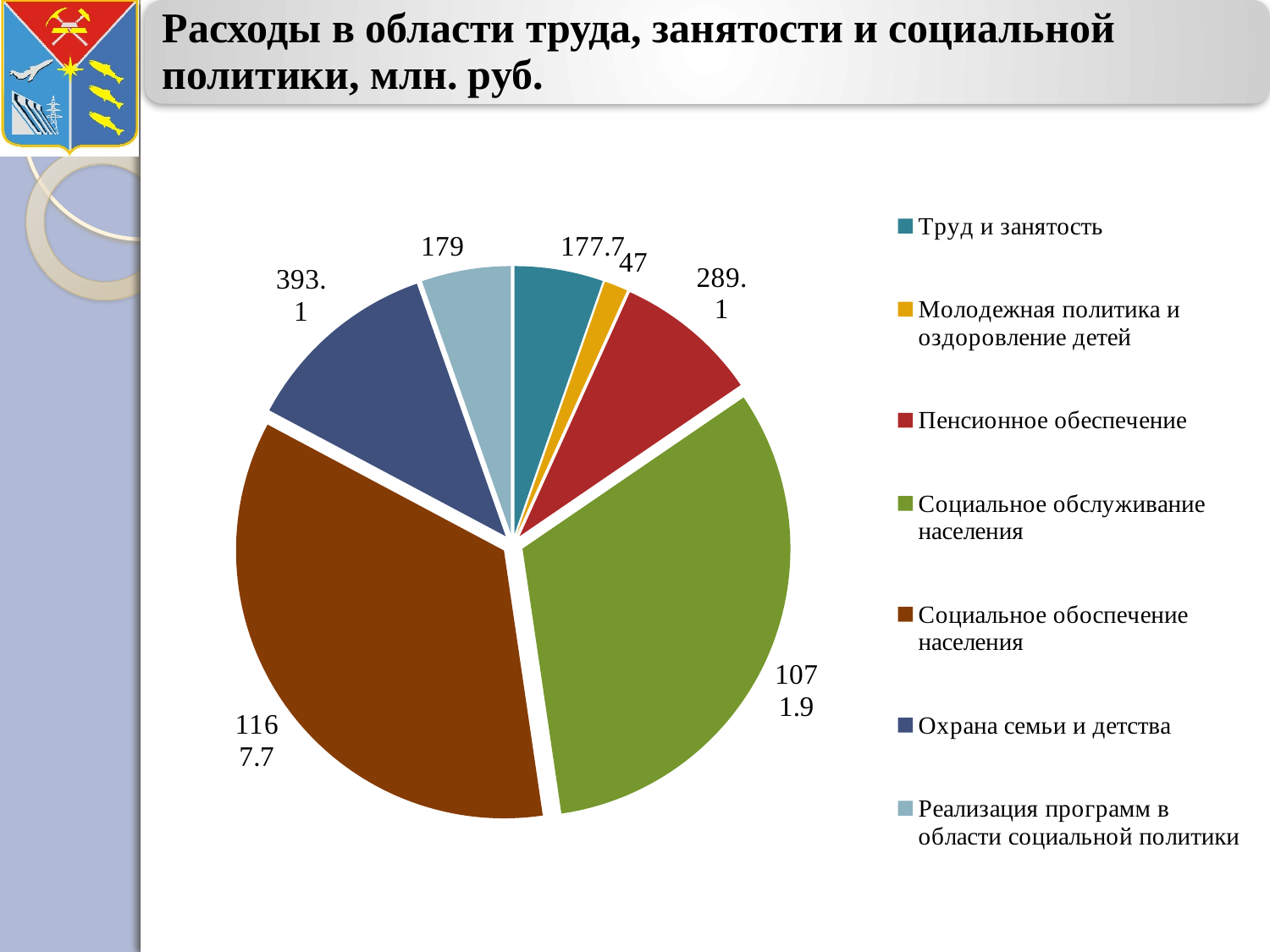
What is the value for Молодежная политика и оздоровление детей? 47 What is the title of the chart? Расходы в области труда, занятости и социальной политики, млн. руб. Which category has the smallest value? Молодежная политика и оздоровление детей What is the value for Охрана семьи и детства? 393.1 Which category has the largest value? Социальное обоспечение населения What is the value for Социальное обслуживание населения? 1071.9 What type of chart is shown on the slide? Pie chart What is the difference between the values for Социальное обоспечение населения and Социальное обслуживание населения? 95.8 Which is larger: Охрана семьи и детства or Пенсионное обеспечение? Охрана семьи и детства What is the value for Пенсионное обеспечение? 289.1 How many categories does the pie chart have? 7 What is the value for Труд и занятость? 177.7